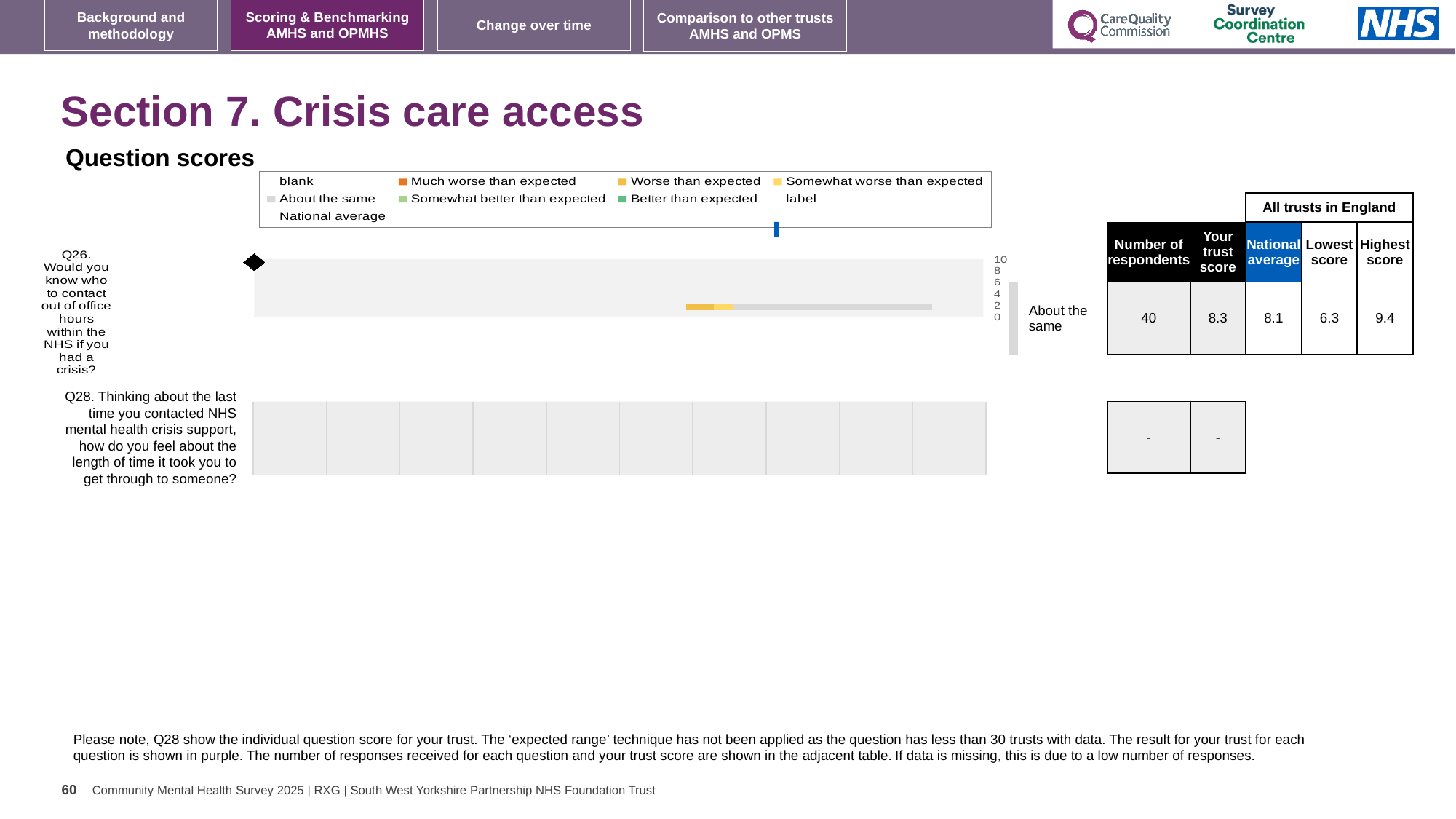
In the table next to the chart, what is the highest score among all trusts in England for Q26? 9.4 What category label is shown for Q26 in the question scores chart? About the same In the table next to the chart, how many respondents answered Q26? 40 In the table next to the chart, what is the national average for Q26? 8.1 What kind of chart is used to show the question scores on this slide? bar chart How many questions are plotted in the question scores chart? 2 Which questions are plotted in the question scores chart? Q26 and Q28 For Q26, which is larger: the trust score or the national average? the trust score For Q26, what is the difference between the highest score and the lowest score among all trusts in England? 3.1 In the table next to the chart, what is the lowest score among all trusts in England for Q26? 6.3 In the table next to the chart, what is the trust score for Q26? 8.3 What colour does the legend use for 'Much worse than expected'? orange